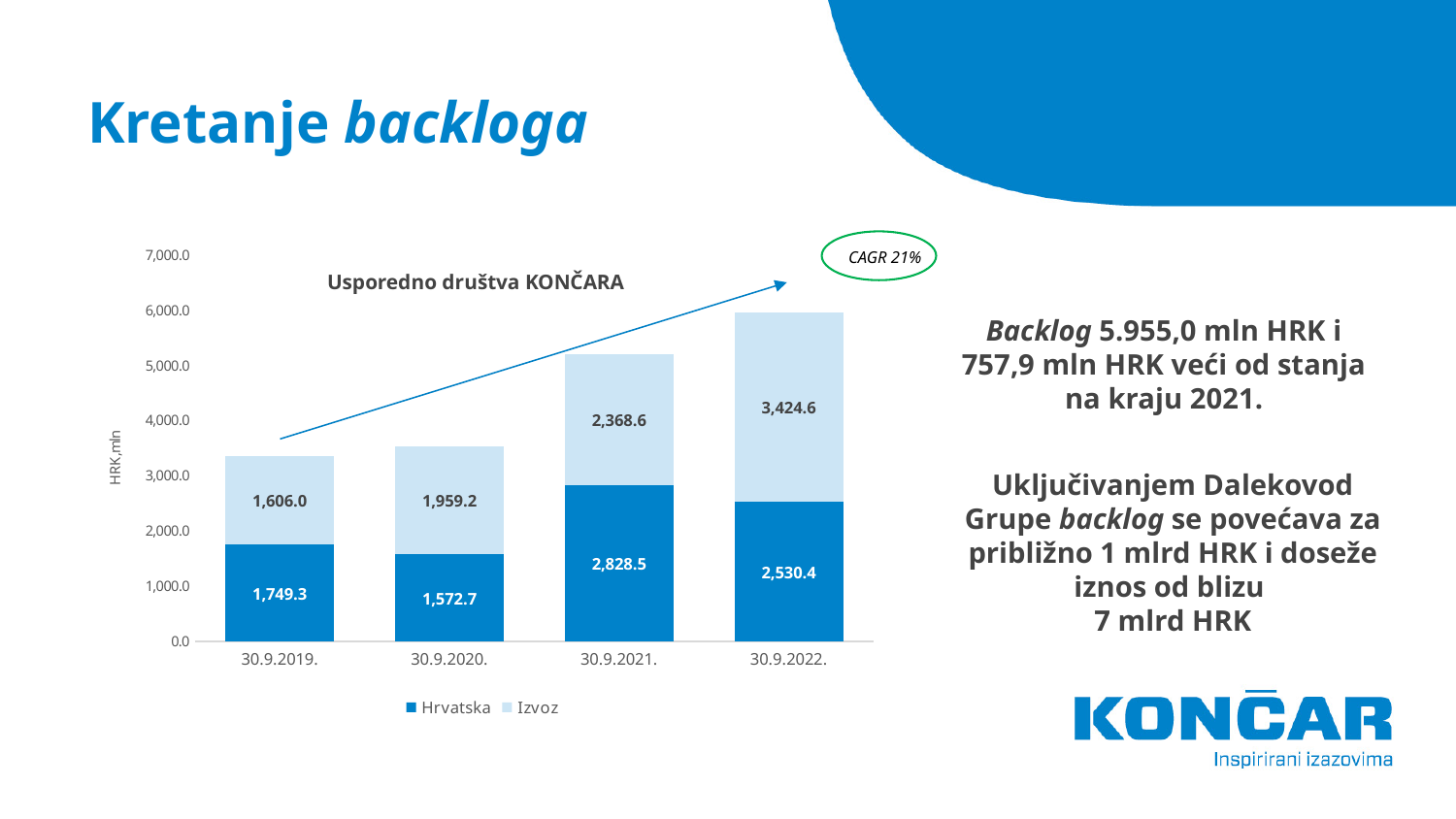
Which date has the highest Hrvatska value? 30.9.2021. What is the Hrvatska value for 30.9.2021.? 2,828.5 Which is larger for 30.9.2020.: Hrvatska or Izvoz? Izvoz What CAGR is shown in the circle above the chart? CAGR 21% What is the total of the stacked bar for 30.9.2022.? 5,955.0 What is the Izvoz value for 30.9.2022.? 3,424.6 How many dates are shown on the x axis? 4 What is the difference between the Izvoz values for 30.9.2022. and 30.9.2021.? 1,056.0 What is the Izvoz value for 30.9.2019.? 1,606.0 Which date has the lowest Izvoz value? 30.9.2019. What type of chart is shown on the slide? Stacked bar chart How many series does the legend list? 2